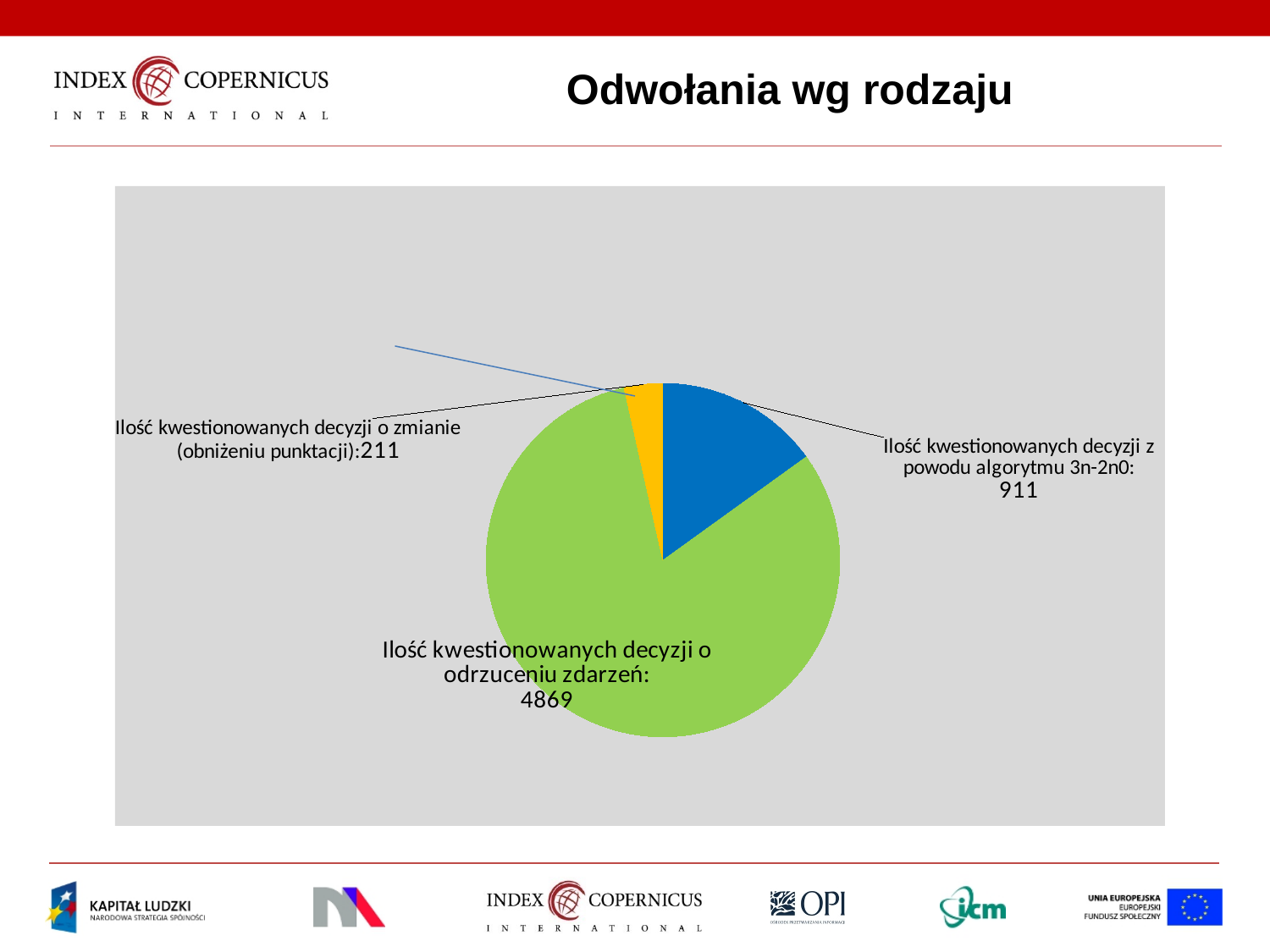
What is the value for "Ilość kwestionowanych decyzji o odrzuceniu zdarzeń"? 4869 Which is larger: the value for "Ilość kwestionowanych decyzji z powodu algorytmu 3n-2n0" or the value for "Ilość kwestionowanych decyzji o zmianie (obniżeniu punktacji)"? Ilość kwestionowanych decyzji z powodu algorytmu 3n-2n0 What is the value for "Ilość kwestionowanych decyzji z powodu algorytmu 3n-2n0"? 911 What is the title of the chart on the slide? Odwołania wg rodzaju Which category has the largest slice of the pie? Ilość kwestionowanych decyzji o odrzuceniu zdarzeń How many slices does the pie chart have? 3 What is the total of all three values shown in the pie chart? 5991 What colour is the slice for "Ilość kwestionowanych decyzji o odrzuceniu zdarzeń"? green What kind of chart is shown on the slide? pie chart What is the difference between the value for decisions rejected due to the 3n-2n0 algorithm (911) and the value for decisions about changing (lowering) the score (211)? 700 Which category has the smallest slice of the pie? Ilość kwestionowanych decyzji o zmianie (obniżeniu punktacji) What is the value for "Ilość kwestionowanych decyzji o zmianie (obniżeniu punktacji)"? 211